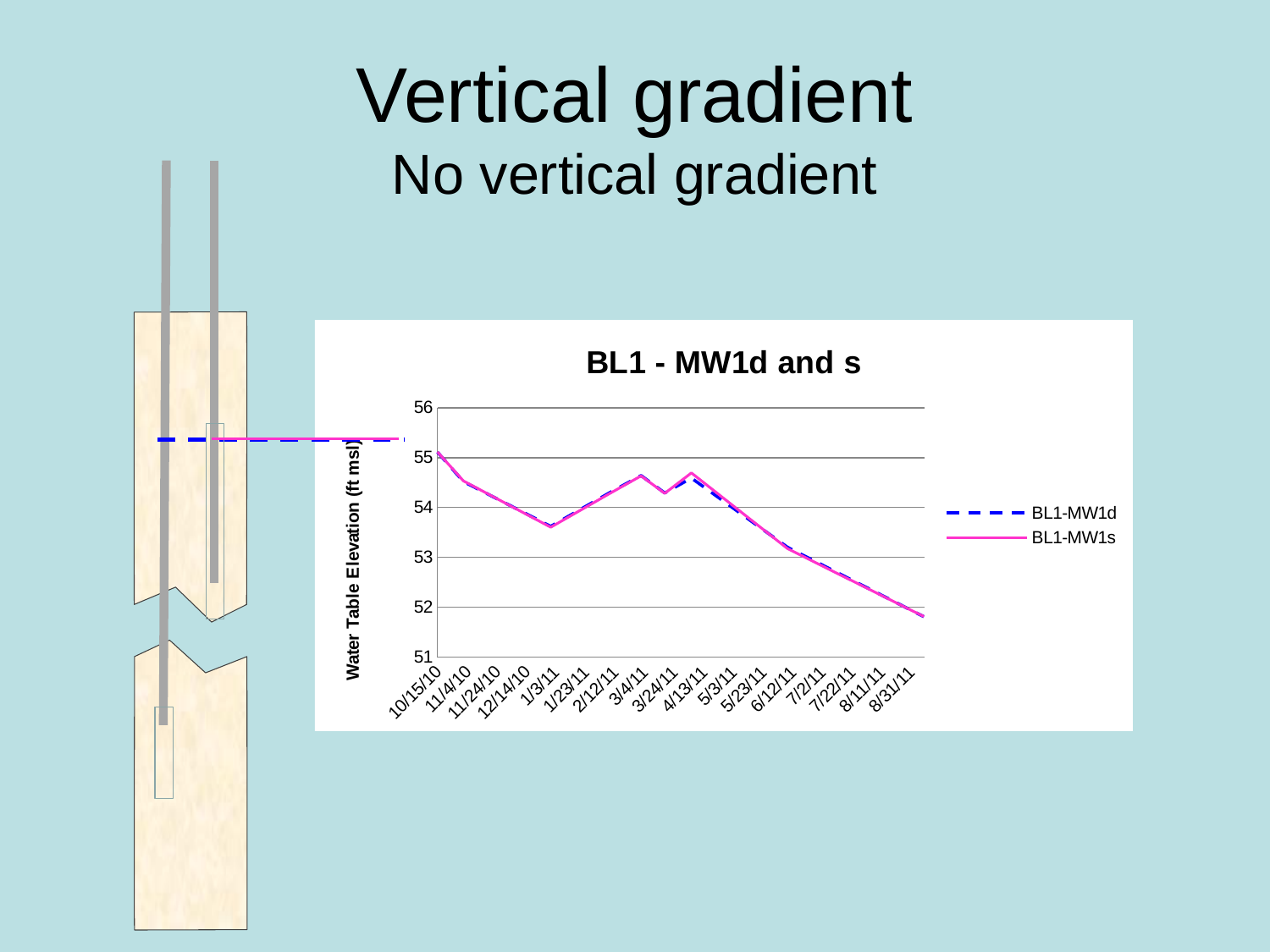
How many series does the legend list? 2 On which date is the BL1-MW1s water table elevation lowest? 8/31/11 What is the title of the chart? BL1 - MW1d and s Is the value for BL1-MW1s on 8/31/11 greater or less than 52? less Is the value for BL1-MW1d on 7/2/11 greater or less than 53? less Is the value for BL1-MW1s on 1/3/11 greater or less than 54? less How many dates are labelled along the x axis? 17 What kind of chart is shown on the slide? line chart What is the label of the y axis? Water Table Elevation (ft msl) On which date is the BL1-MW1s water table elevation highest? 10/15/10 Overall, do the water table elevations rise or fall from 10/15/10 to 8/31/11? fall